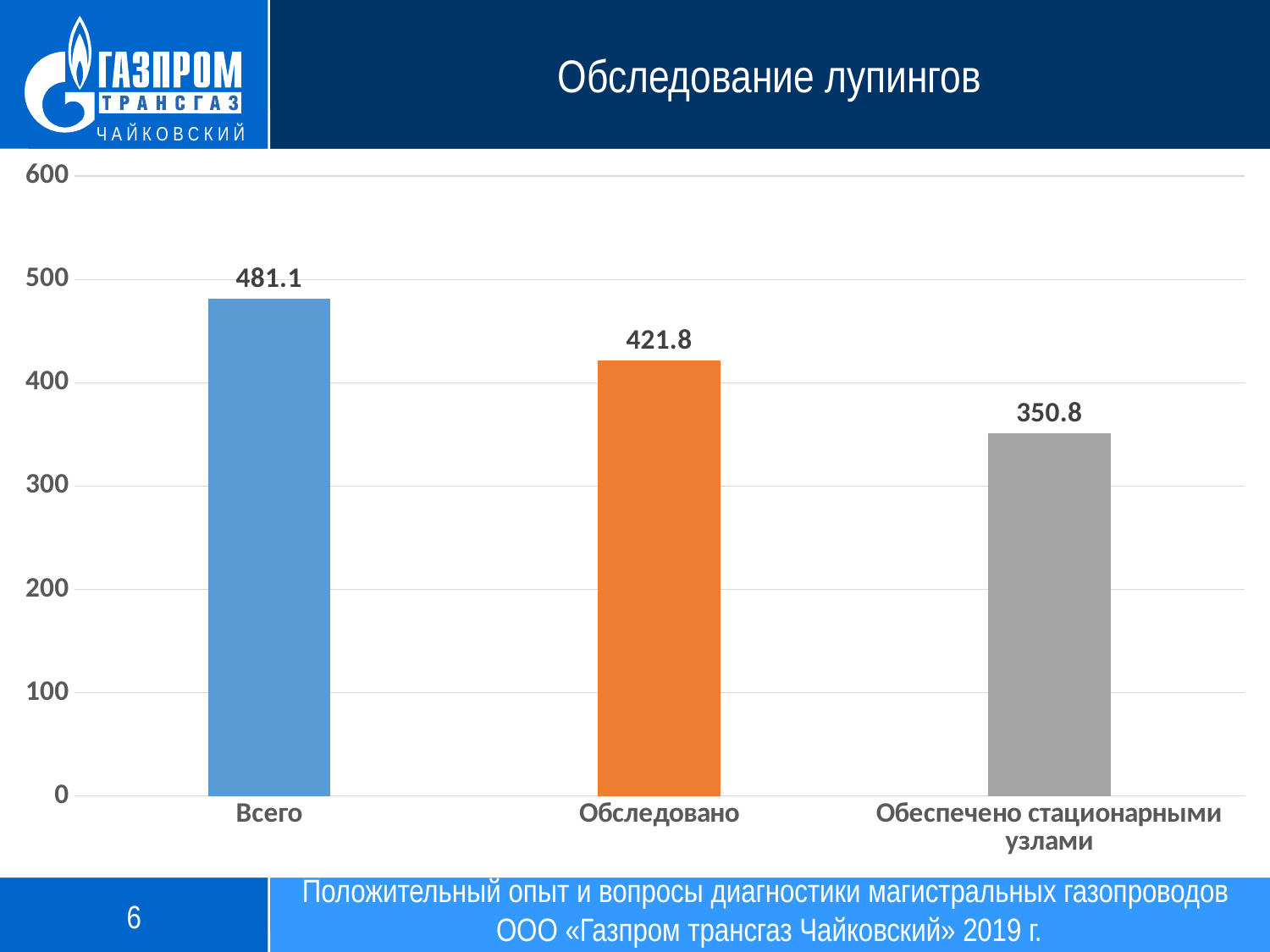
What is the value for Обследовано? 421.8 What is the title of the slide containing the chart? Обследование лупингов Which is larger, Обследовано or Обеспечено стационарными узлами? Обследовано What kind of chart is shown on the slide? bar chart What is the difference between Обследовано and Обеспечено стационарными узлами? 71.0 Which category has the highest value? Всего Which category has the lowest value? Обеспечено стационарными узлами What is the difference between Всего and Обследовано? 59.3 How many categories are shown in the chart? 3 What is the value for Обеспечено стационарными узлами? 350.8 Is the value for Обеспечено стационарными узлами greater or less than 400? less What is the value for Всего? 481.1